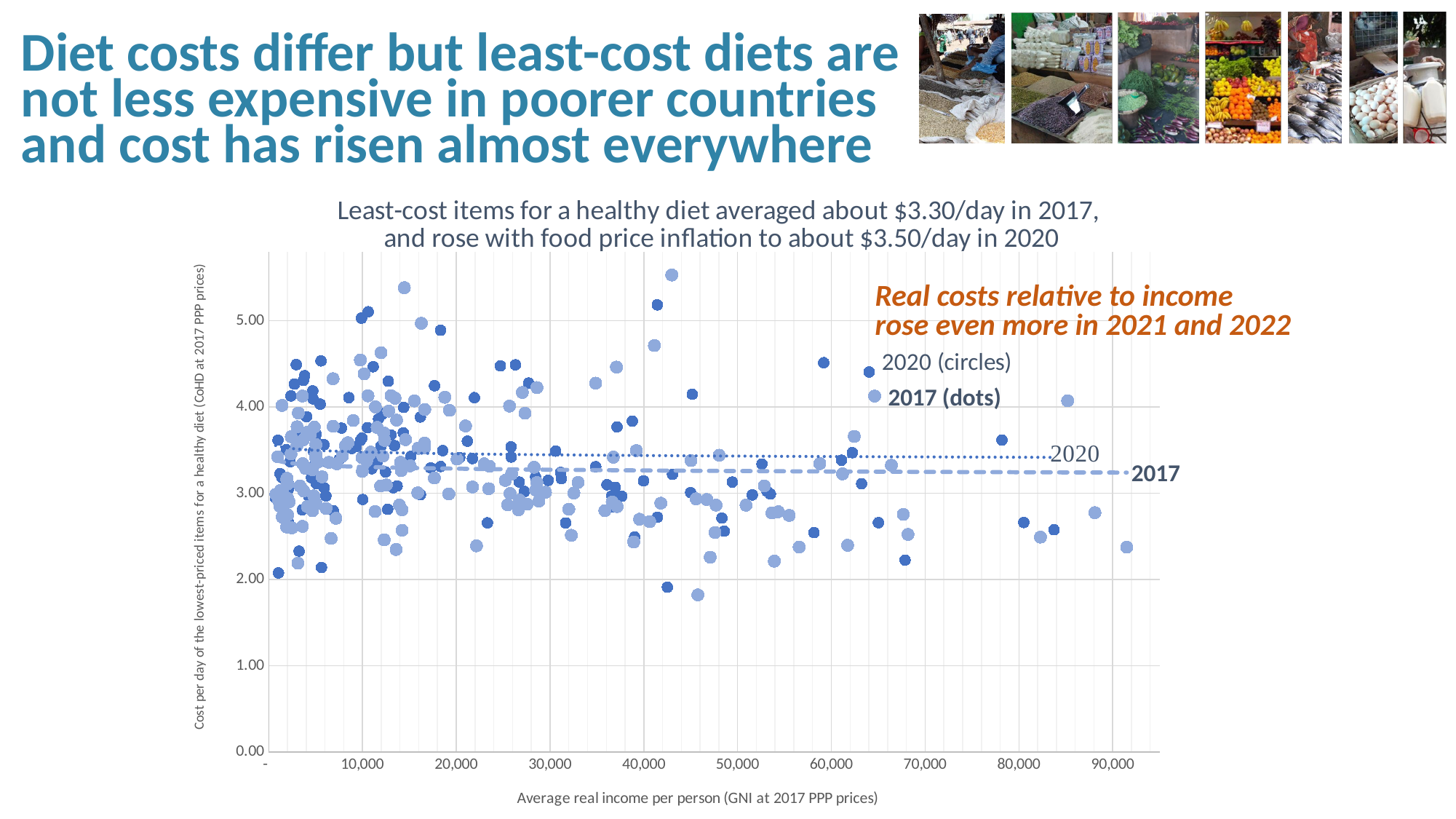
Do the trend lines for 2017 and 2020 rise, fall, or stay roughly flat as income increases along the x axis? Roughly flat Which two years are plotted in the chart? 2017 and 2020 How many series does the chart's legend list? 2 Is the lowest plotted point on the chart greater or less than 2.00? less What is the label of the horizontal axis? Average real income per person (GNI at 2017 PPP prices) According to the chart title, about how much did least-cost items for a healthy diet cost per day in 2020? About $3.50/day Which year's trend line sits higher on the chart, 2020 or 2017? 2020 According to the chart title, about how much did least-cost items for a healthy diet average per day in 2017? About $3.30/day What kind of chart is shown on the slide? Scatter chart What is the highest tick value shown on the horizontal axis? 90,000 What is the highest value shown on the vertical axis? 5.00 Is the highest plotted point on the chart greater or less than 5.00? greater